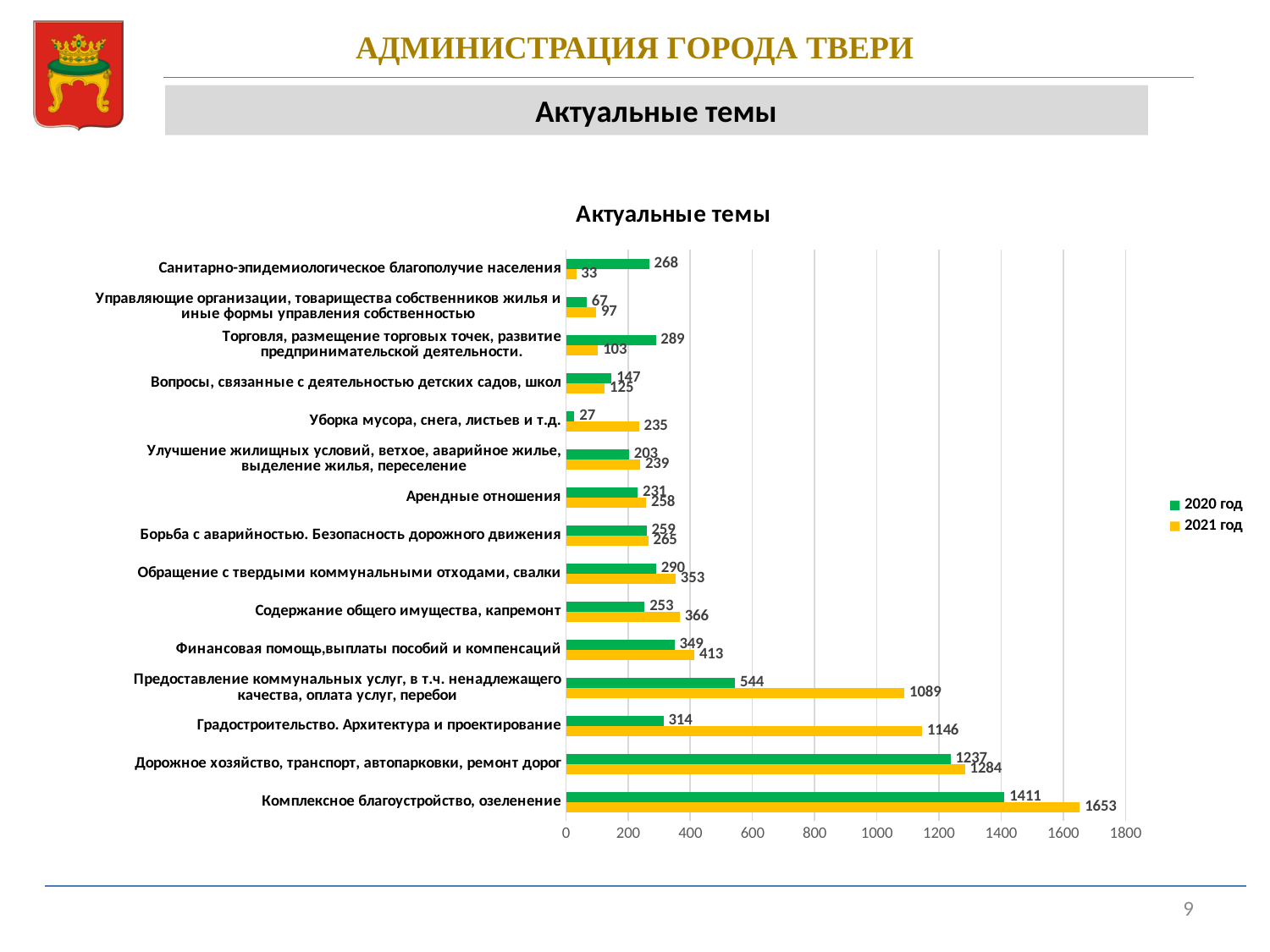
What is the difference between the 2021 год and 2020 год values for Предоставление коммунальных услуг, в т.ч. ненадлежащего качества, оплата услуг, перебои? 545 How many categories are shown in the chart? 15 Which category has the highest 2021 год value? Комплексное благоустройство, озеленение What is the 2021 год value for Комплексное благоустройство, озеленение? 1653 Which category has the lowest 2020 год value? Уборка мусора, снега, листьев и т.д. What is the 2020 год value for Градостроительство. Архитектура и проектирование? 314 What is the 2021 год value for Уборка мусора, снега, листьев и т.д.? 235 What kind of chart is shown on the slide? bar chart Which is larger for Санитарно-эпидемиологическое благополучие населения: the 2020 год value or the 2021 год value? 2020 год How many series does the legend list? 2 What colour represents the 2021 год series? yellow Is the 2020 год value for Дорожное хозяйство, транспорт, автопарковки, ремонт дорог greater or less than 1000? greater